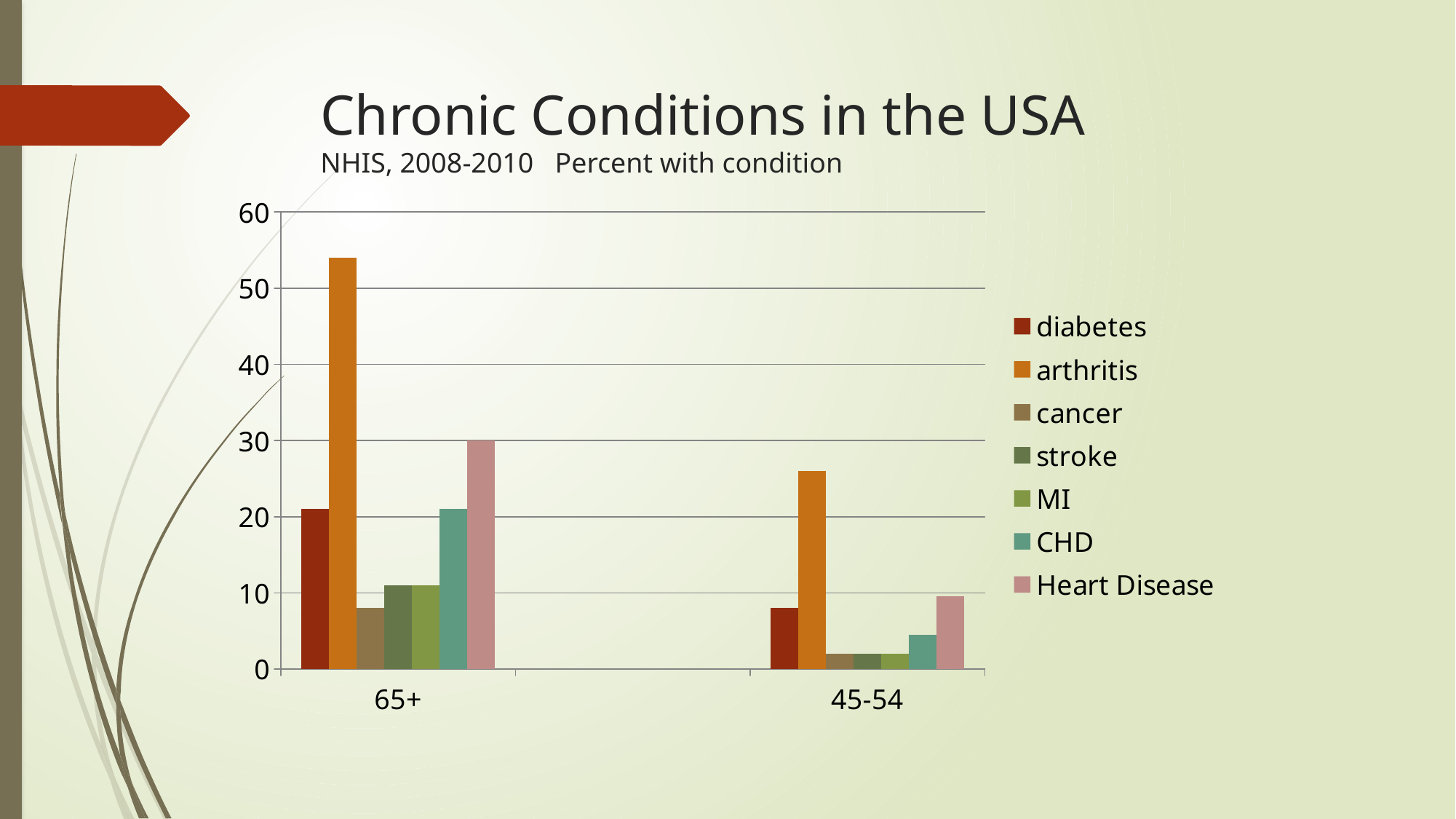
Is the diabetes value for the 65+ group greater or less than 20? greater How many age groups are shown on the x axis? 2 Which is larger, the arthritis value for 65+ or the arthritis value for 45-54? 65+ How many series does the legend list? 7 Do the values for each condition rise or fall from the 65+ group to the 45-54 group? fall Which condition has the lowest value for the 65+ age group? cancer Is the arthritis value for the 65+ group greater or less than 50? greater What is the title of the chart? Chronic Conditions in the USA Which condition has the highest value for the 45-54 age group? arthritis What kind of chart is shown on the slide? bar chart Which condition has the highest value for the 65+ age group? arthritis